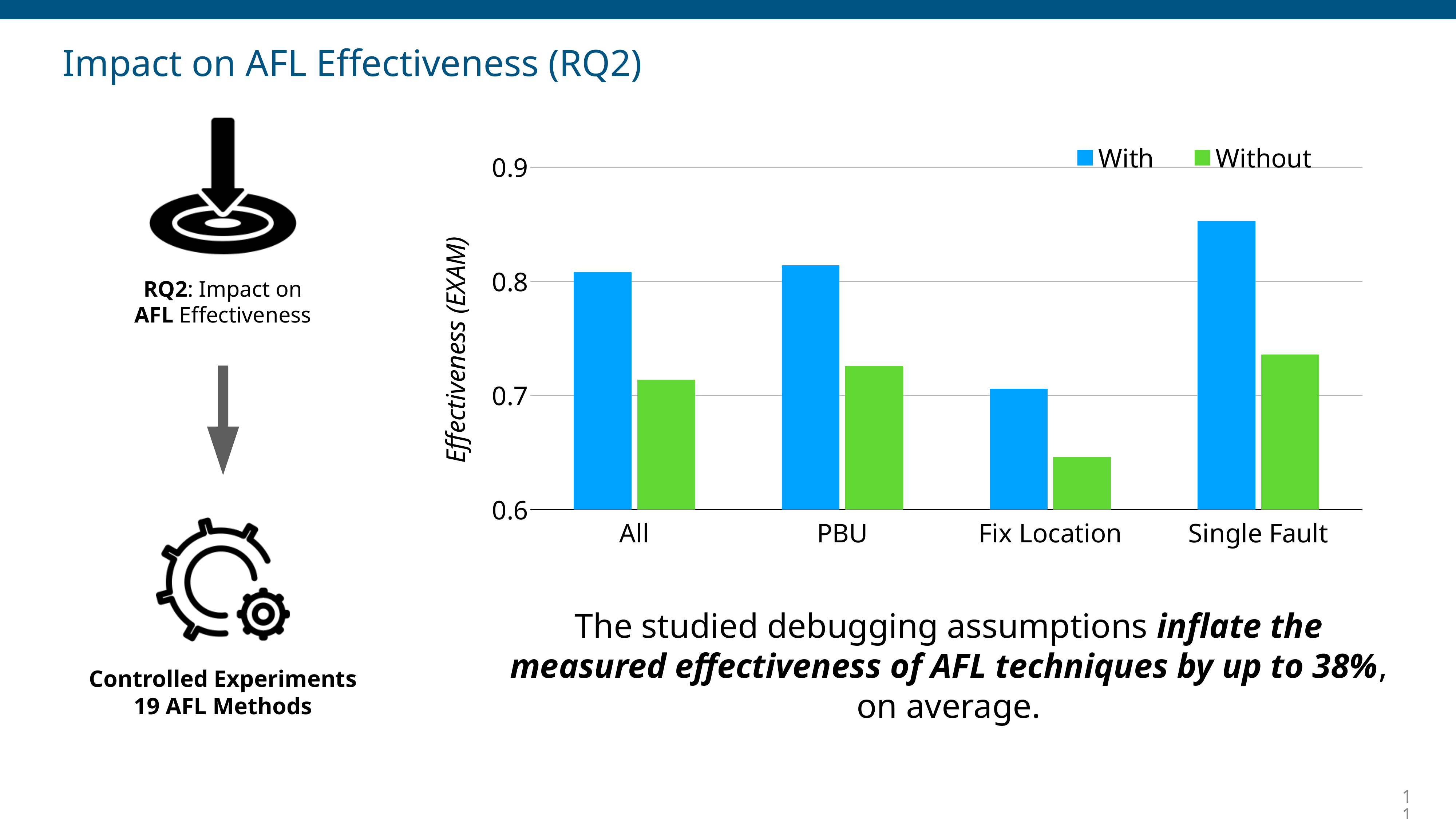
Is the 'Without' value for Fix Location greater or less than 0.7? less For the Single Fault category, which is larger: the 'With' value or the 'Without' value? With What is the label of the chart's y axis? Effectiveness (EXAM) Which category has the lowest 'Without' value? Fix Location Is the 'With' value for Single Fault greater or less than 0.8? greater Which category has the highest 'With' value? Single Fault How many categories are shown on the x axis of the chart? 4 Is the 'With' value for PBU greater or less than 0.8? greater For the Fix Location category, which is larger: the 'With' value or the 'Without' value? With What kind of chart is shown on the slide? bar chart Which colour represents the 'Without' series in the chart? green How many series does the chart's legend list? 2